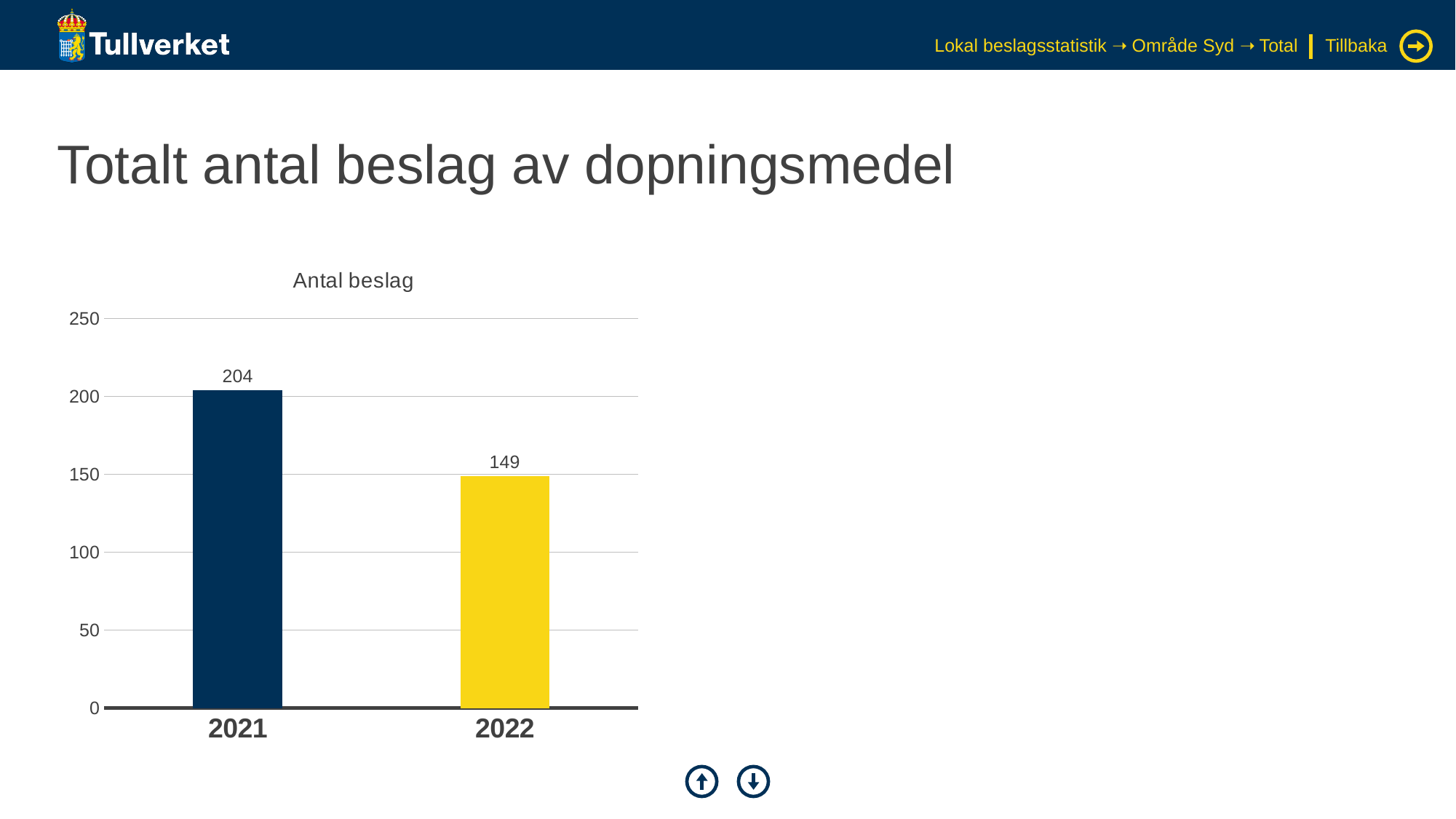
Which is larger, the value for 2021 or the value for 2022? 2021 What is the value for 2022? 149 What is the value for 2021? 204 How many years are shown on the x axis? 2 Is the value for 2021 greater or less than 200? greater What is the difference between the values for 2021 and 2022? 55 Do the values rise or fall from 2021 to 2022? fall What kind of chart is shown on the slide? bar chart Which year has the highest number of seizures? 2021 Is the value for 2022 greater or less than 150? less Which year has the lowest number of seizures? 2022 What is the title of the chart? Antal beslag